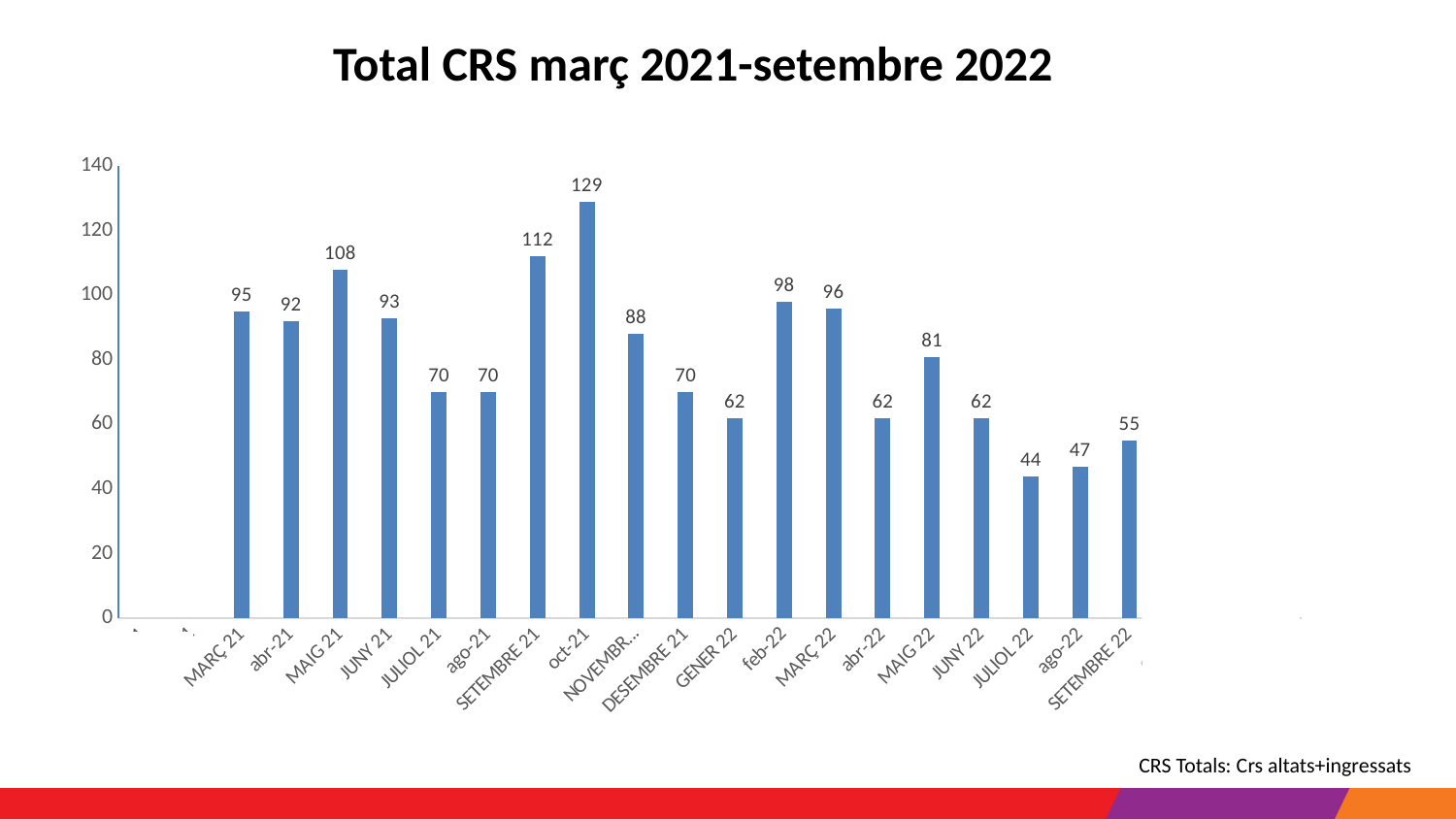
What is the difference between the values for MARÇ 21 and MARÇ 22? 1 What is the value for SETEMBRE 22? 55 Which month has the lowest value? JULIOL 22 How many bars are plotted in the chart? 19 What is the value for feb-22? 98 Which is larger, the value for MAIG 22 or the value for JUNY 22? MAIG 22 What is the difference between the values for oct-21 and SETEMBRE 21? 17 What is the value for oct-21? 129 Which month has the highest value? oct-21 What kind of chart is shown on the slide? Bar chart What is the value for MAIG 21? 108 What is the title of the chart? Total CRS març 2021-setembre 2022